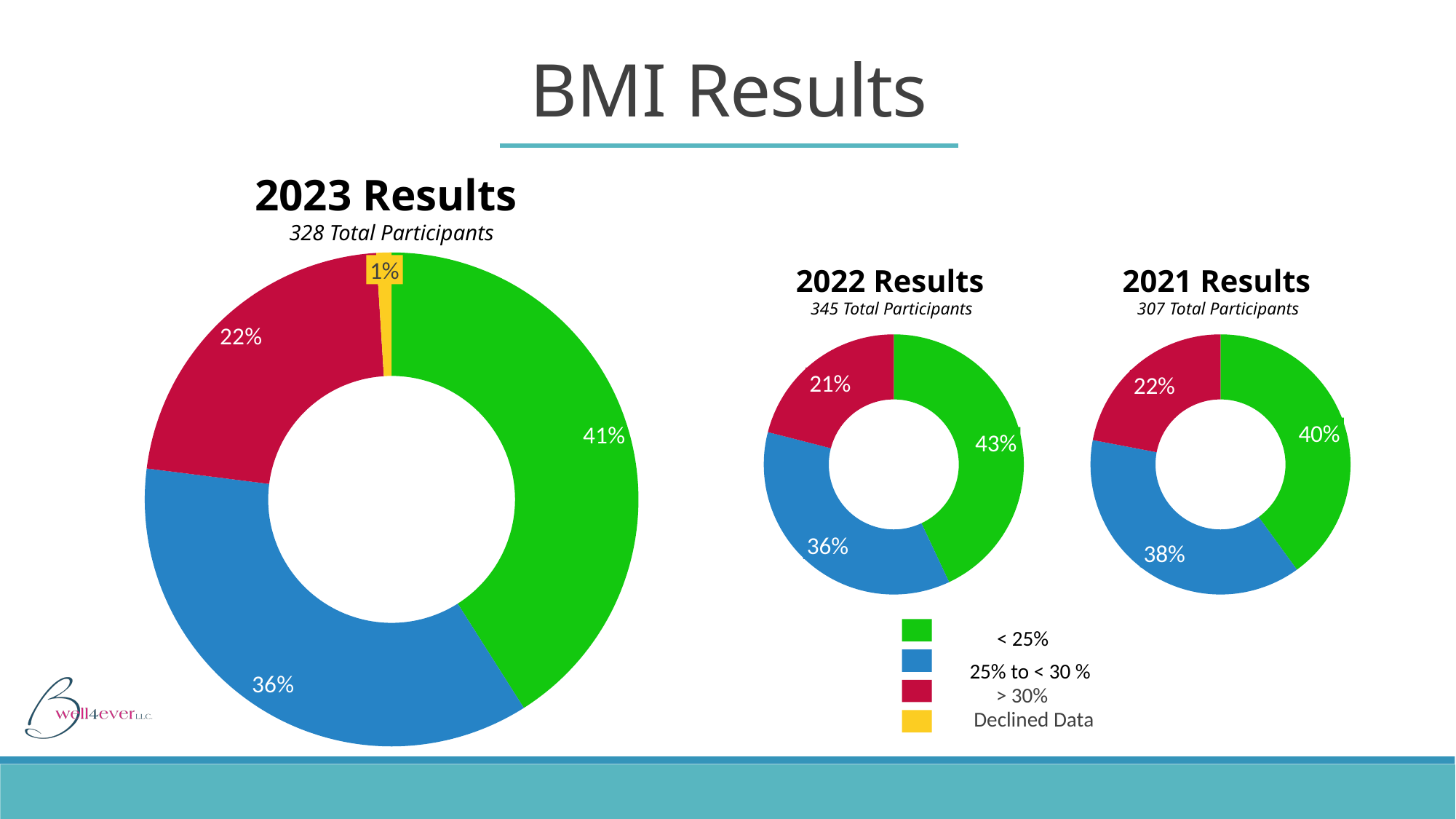
How many slices does the 2023 Results chart have? 4 In the 2023 Results chart, which category has the largest share? < 25% In the 2023 Results chart, what percentage is labelled Declined Data? 1% What kind of chart is used for the 2023 Results? Doughnut chart Which is larger: the < 25% share in the 2022 Results chart or the < 25% share in the 2021 Results chart? 2022 Results In the 2021 Results chart, which category has the smallest share? > 30% In the 2022 Results chart, what percentage of participants had a BMI of > 30%? 21% In the 2022 Results chart, what is the difference between the < 25% share and the > 30% share? 22 percentage points How many total participants are reported for the 2022 Results chart? 345 In the 2023 Results chart, which category has the smallest share? Declined Data In the 2023 Results chart, what percentage of participants had a BMI of < 25%? 41% In the 2021 Results chart, what percentage of participants had a BMI of 25% to < 30%? 38%